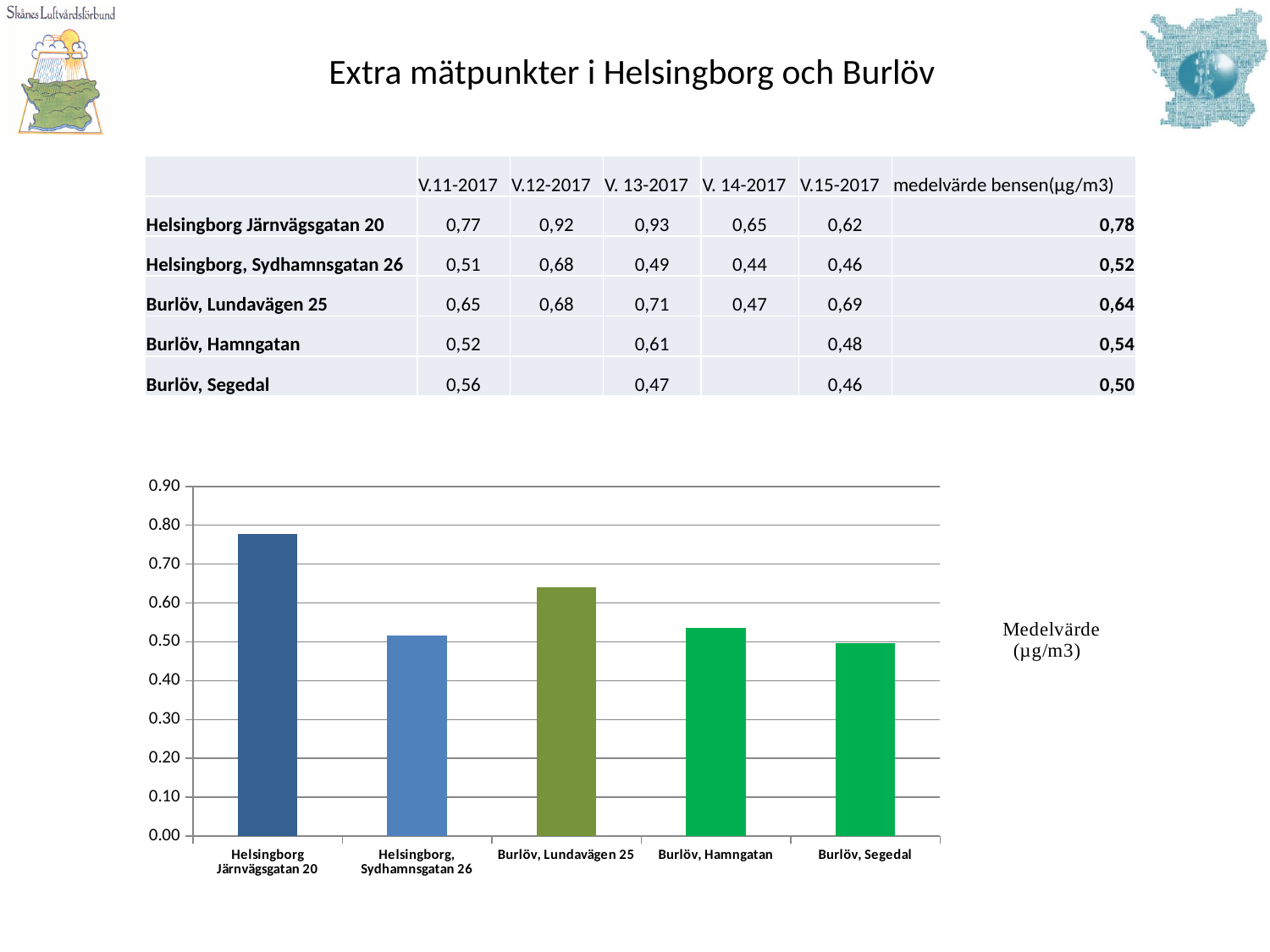
Which site has the highest bar in the chart? Helsingborg Järnvägsgatan 20 Is the value for Burlöv, Lundavägen 25 greater or less than 0.60? greater What label and unit are written to the right of the chart? Medelvärde (µg/m3) Is the value for Helsingborg Järnvägsgatan 20 greater or less than 0.70? greater What is the highest value shown on the chart's vertical axis? 0.90 Which is larger in the chart, Burlöv, Lundavägen 25 or Burlöv, Segedal? Burlöv, Lundavägen 25 Which is larger in the chart, Helsingborg Järnvägsgatan 20 or Helsingborg, Sydhamnsgatan 26? Helsingborg Järnvägsgatan 20 Is the value for Helsingborg, Sydhamnsgatan 26 greater or less than 0.60? less How many measurement sites (bars) are shown in the chart? 5 What kind of chart is shown on the slide? bar chart